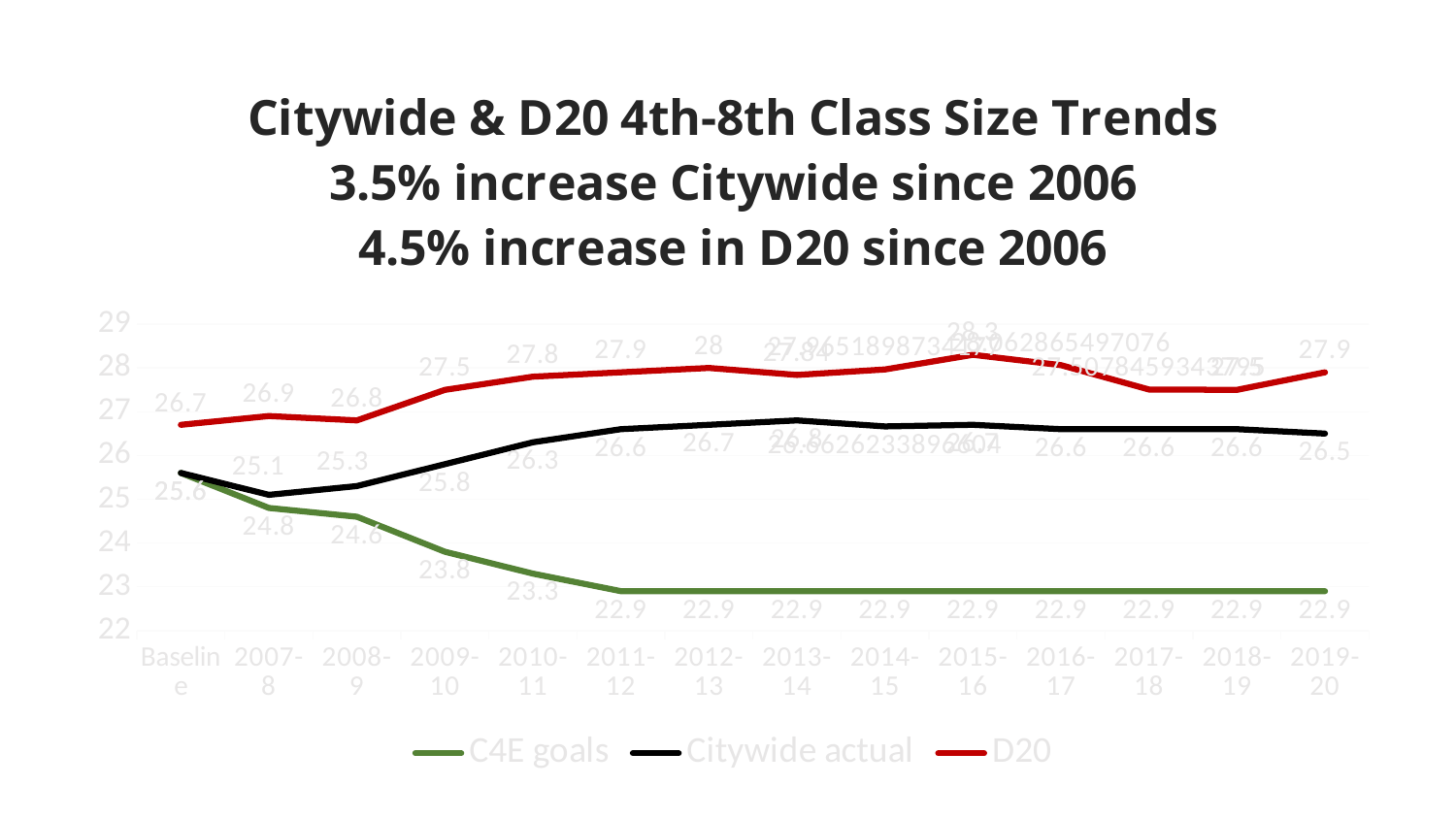
How many series does the legend list? 3 What is the difference between the D20 and Citywide actual values in 2019-20? 1.4 How many school-year categories are shown on the x axis, including Baseline? 14 What is the D20 value for 2019-20? 27.9 What kind of chart is shown on the slide? line chart Which is larger in 2010-11, the D20 value or the Citywide actual value? D20 What is the D20 value for 2009-10? 27.5 Which colour is used for the D20 line? red What is the C4E goals value for 2009-10? 23.8 In which year is the Citywide actual value lowest? 2007-8 Do the C4E goals values rise or fall from Baseline to 2011-12? fall What is the Citywide actual value for 2019-20? 26.5